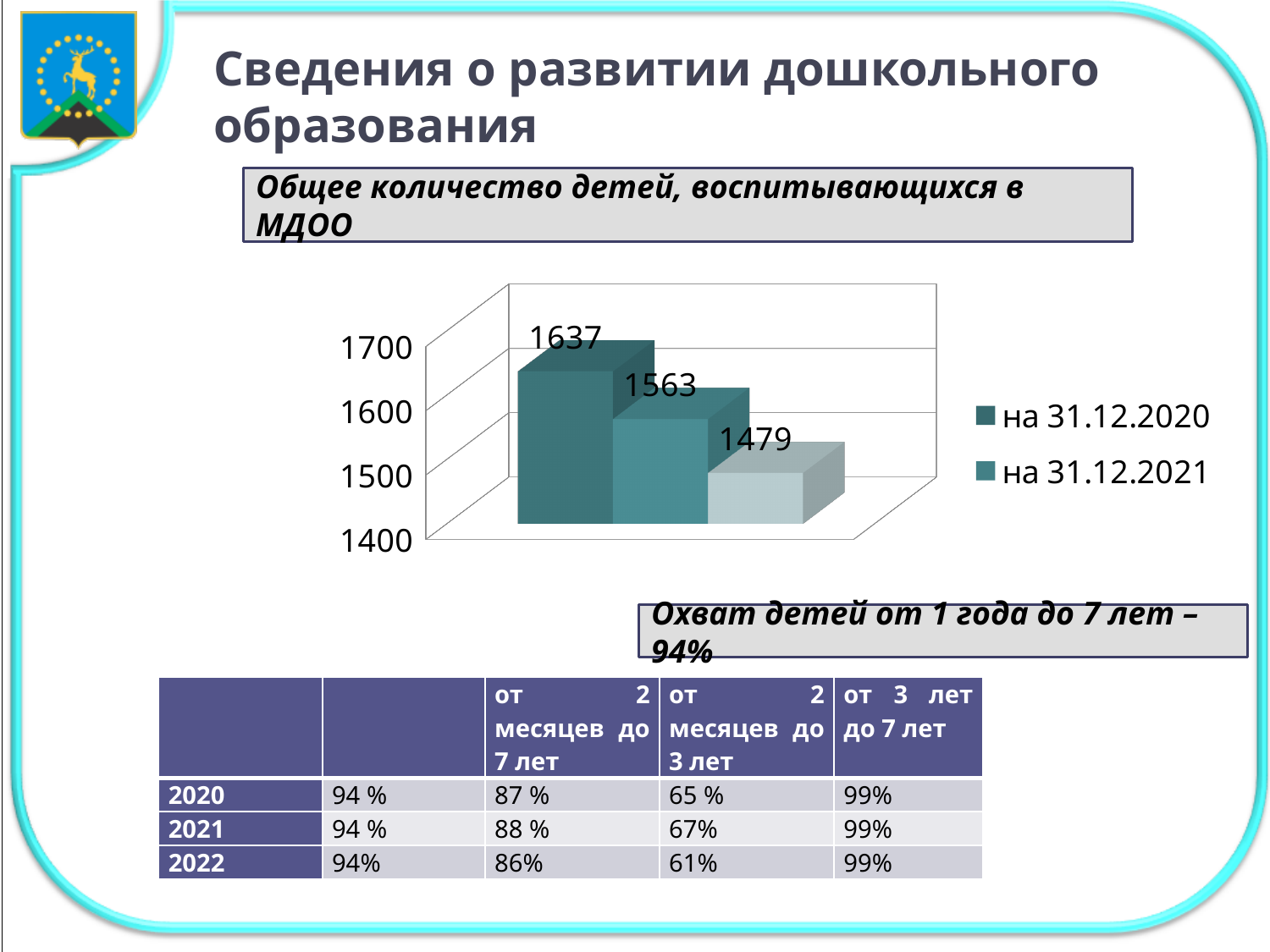
Which is larger, the value for "на 31.12.2020" or for "на 31.12.2021"? на 31.12.2020 Is the value of the rightmost bar greater or less than 1500? less How many entries does the chart legend list? 2 What is the value of the bar for "на 31.12.2020"? 1637 Do the bar values rise or fall from left to right across the chart? fall What is the difference between the values for "на 31.12.2020" and "на 31.12.2021"? 74 Which bar has the highest value in the chart? на 31.12.2020 (1637) What is the lowest value shown on the chart? 1479 What value is labelled on the rightmost (lightest) bar of the chart? 1479 How many bars are plotted on the chart? 3 What is the value of the bar for "на 31.12.2021"? 1563 What is the difference between the highest and lowest bars on the chart? 158